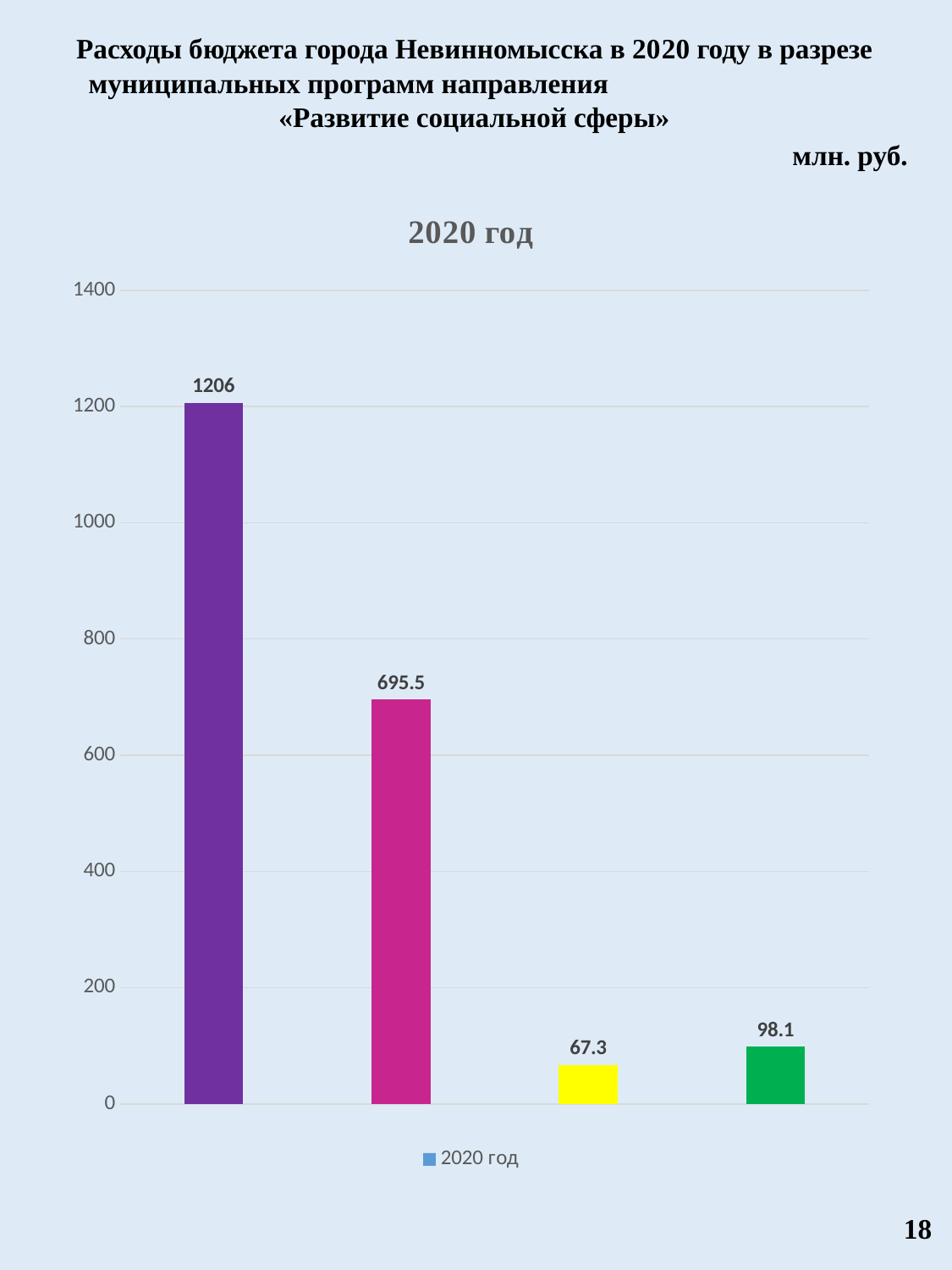
What is the value of the first (purple) bar in the chart? 1206 What is the difference between the fourth (green) bar and the third (yellow) bar? 30.8 Which is larger, the third (yellow) bar or the fourth (green) bar? The fourth (green) bar Which bar has the lowest value in the chart? The third (yellow) bar, 67.3 Which bar has the highest value in the chart? The first (purple) bar, 1206 What is the title of the chart? 2020 год What type of chart is shown on the slide? Bar chart What is the value of the second (magenta) bar in the chart? 695.5 What is the value of the fourth (green) bar in the chart? 98.1 How many bars are plotted in the chart? 4 What is the difference between the first (purple) bar and the second (magenta) bar? 510.5 What is the value of the third (yellow) bar in the chart? 67.3